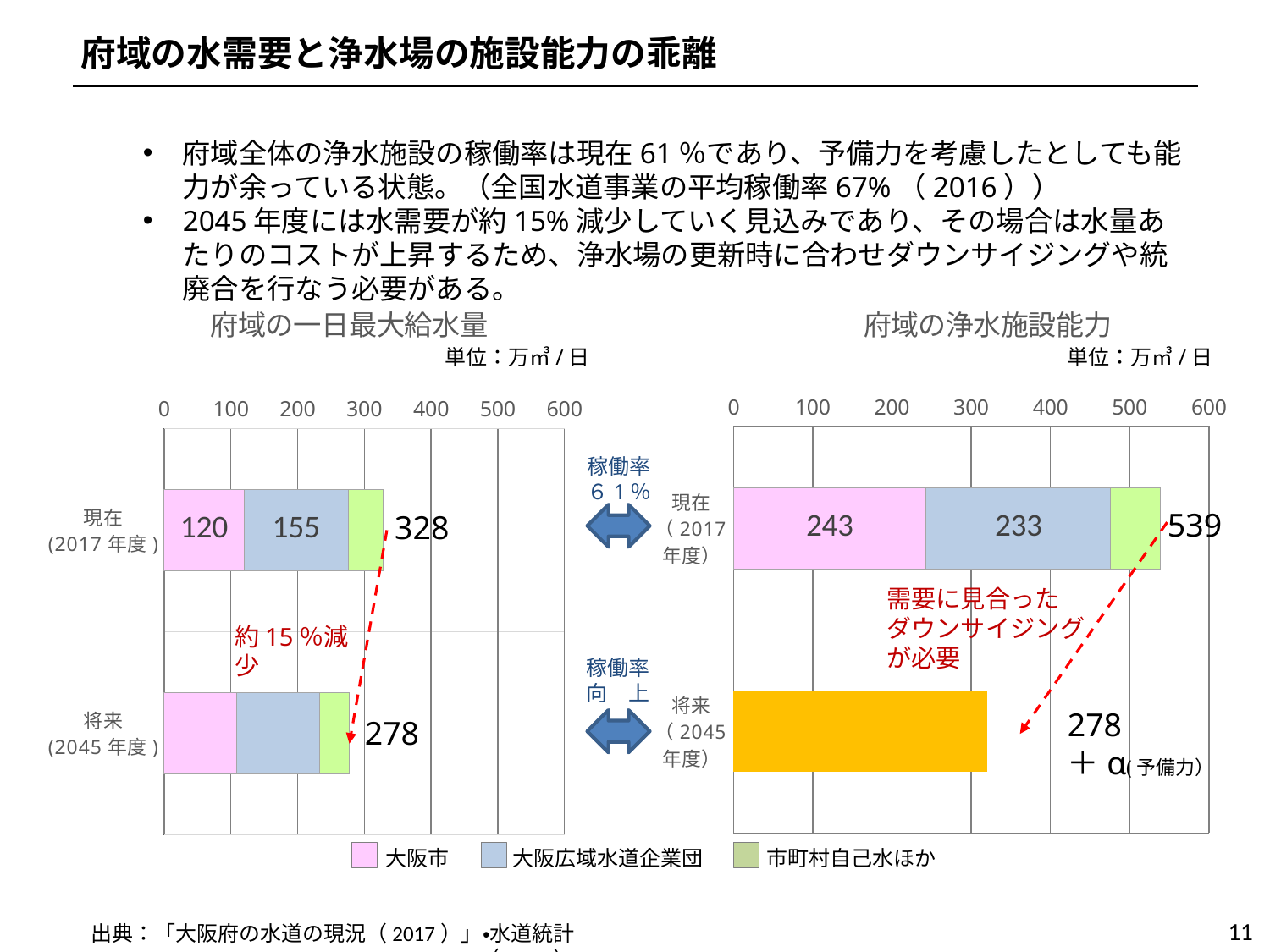
In the left chart (府域の一日最大給水量), what is the total of the stacked bar for 現在(2017年度)? 328 In the right chart (府域の浄水施設能力), is the bar for 将来(2045年度) greater or less than 200? greater In the left chart (府域の一日最大給水量), what is the value for 大阪市 in 現在(2017年度)? 120 In the left chart (府域の一日最大給水量), what is the total of the stacked bar for 将来(2045年度)? 278 What kind of chart is the left chart (府域の一日最大給水量)? Stacked bar chart In the right chart (府域の浄水施設能力), what is the value for 大阪広域水道企業団 in 現在(2017年度)? 233 How many series does the shared legend below the charts list? 3 In the right chart (府域の浄水施設能力), which is larger for 現在(2017年度): 大阪市 or 大阪広域水道企業団? 大阪市 In the left chart (府域の一日最大給水量), what is the difference between the 現在(2017年度) total and the 将来(2045年度) total? 50 In the right chart (府域の浄水施設能力), what is the value for 大阪市 in 現在(2017年度)? 243 In the right chart (府域の浄水施設能力), what is the total of the stacked bar for 現在(2017年度)? 539 In the left chart (府域の一日最大給水量), what is the value for 大阪広域水道企業団 in 現在(2017年度)? 155